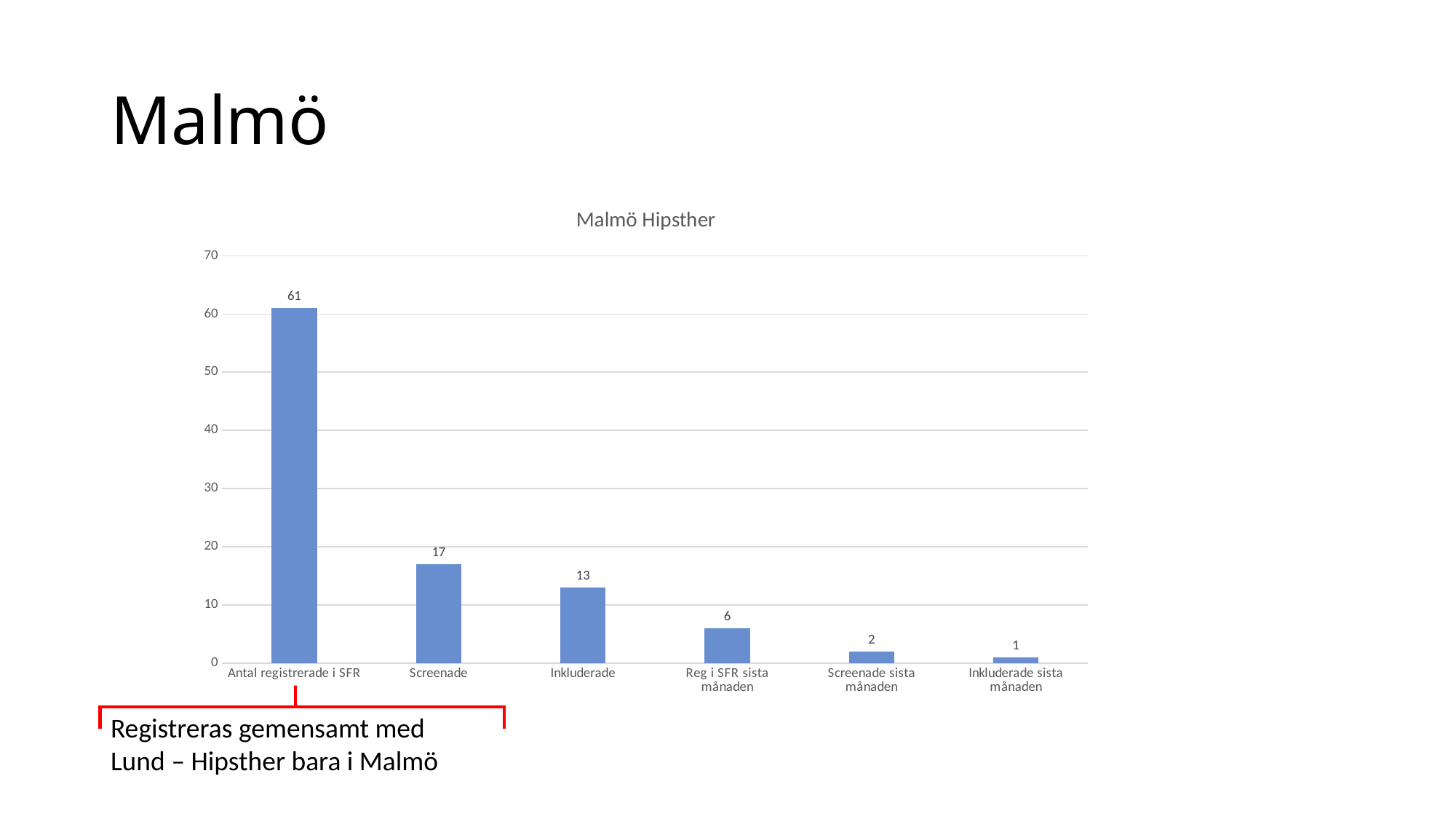
What kind of chart is shown? bar chart What is the value for Screenade? 17 How many categories are shown on the x axis? 6 Which category has the lowest value? Inkluderade sista månaden What is the title of the chart? Malmö Hipsther What is the value for Reg i SFR sista månaden? 6 What is the value for Antal registrerade i SFR? 61 What is the difference between the values for Screenade and Inkluderade? 4 Is the value for Antal registrerade i SFR greater or less than 50? greater Which is larger, the value for Screenade sista månaden or the value for Inkluderade sista månaden? Screenade sista månaden What is the value for Inkluderade? 13 Which category has the highest value? Antal registrerade i SFR